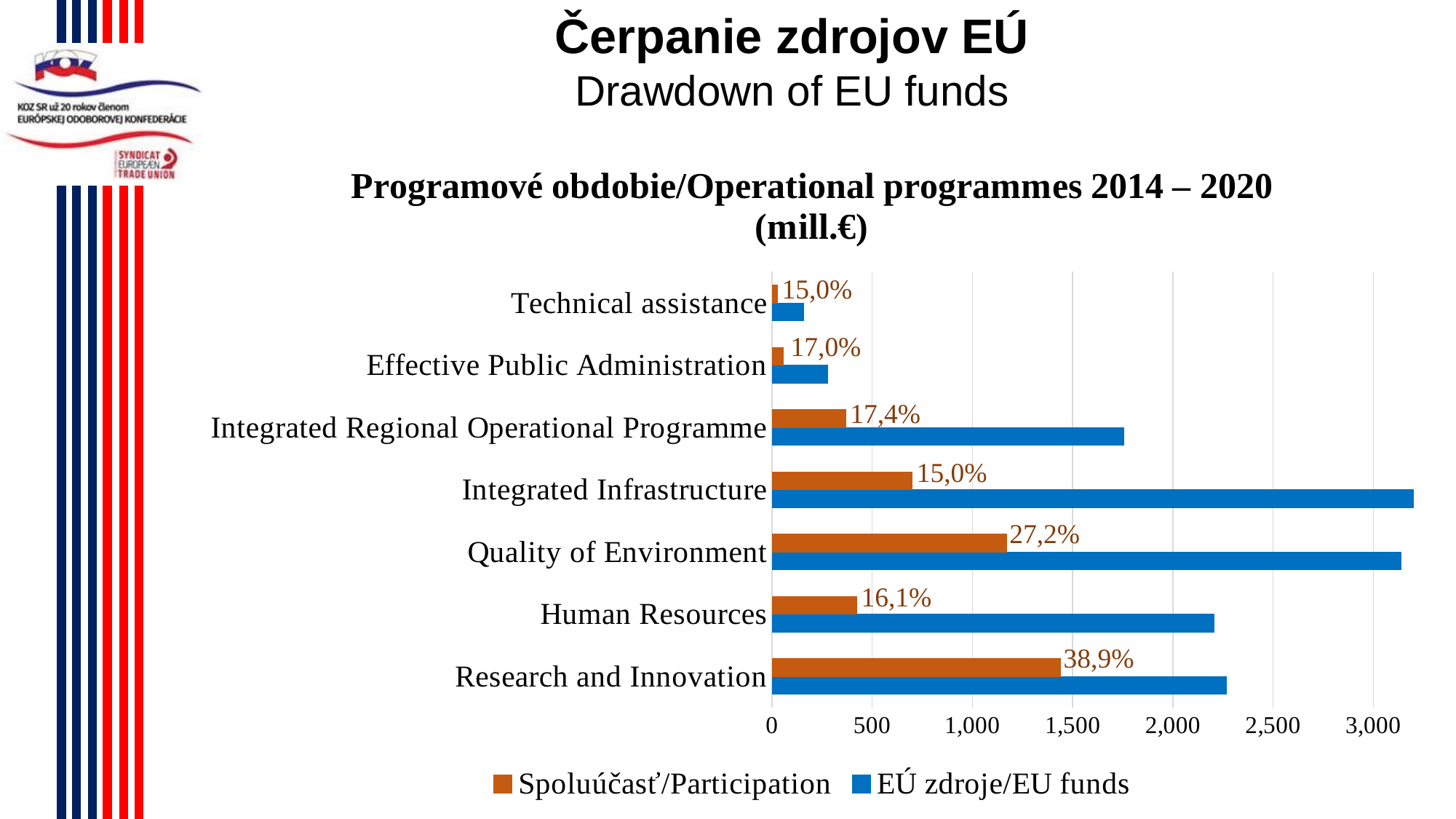
What kind of chart is shown on the slide? bar chart How many operational programmes (categories) are listed on the chart? 7 What percentage label is shown next to the Participation bar for Research and Innovation? 38,9% What percentage label is shown next to the Participation bar for Human Resources? 16,1% Which programme has the lowest EU funds value? Technical assistance Is the EU funds value for Research and Innovation greater or less than 2,000? greater What percentage label is shown next to the Participation bar for Quality of Environment? 27,2% Which series is shown in blue according to the legend? EÚ zdroje/EU funds How many series does the chart legend list? 2 Which programme has the highest Participation value? Research and Innovation Is the EU funds value for Integrated Regional Operational Programme greater or less than 2,000? less What percentage label is shown next to the Participation bar for Integrated Regional Operational Programme? 17,4%